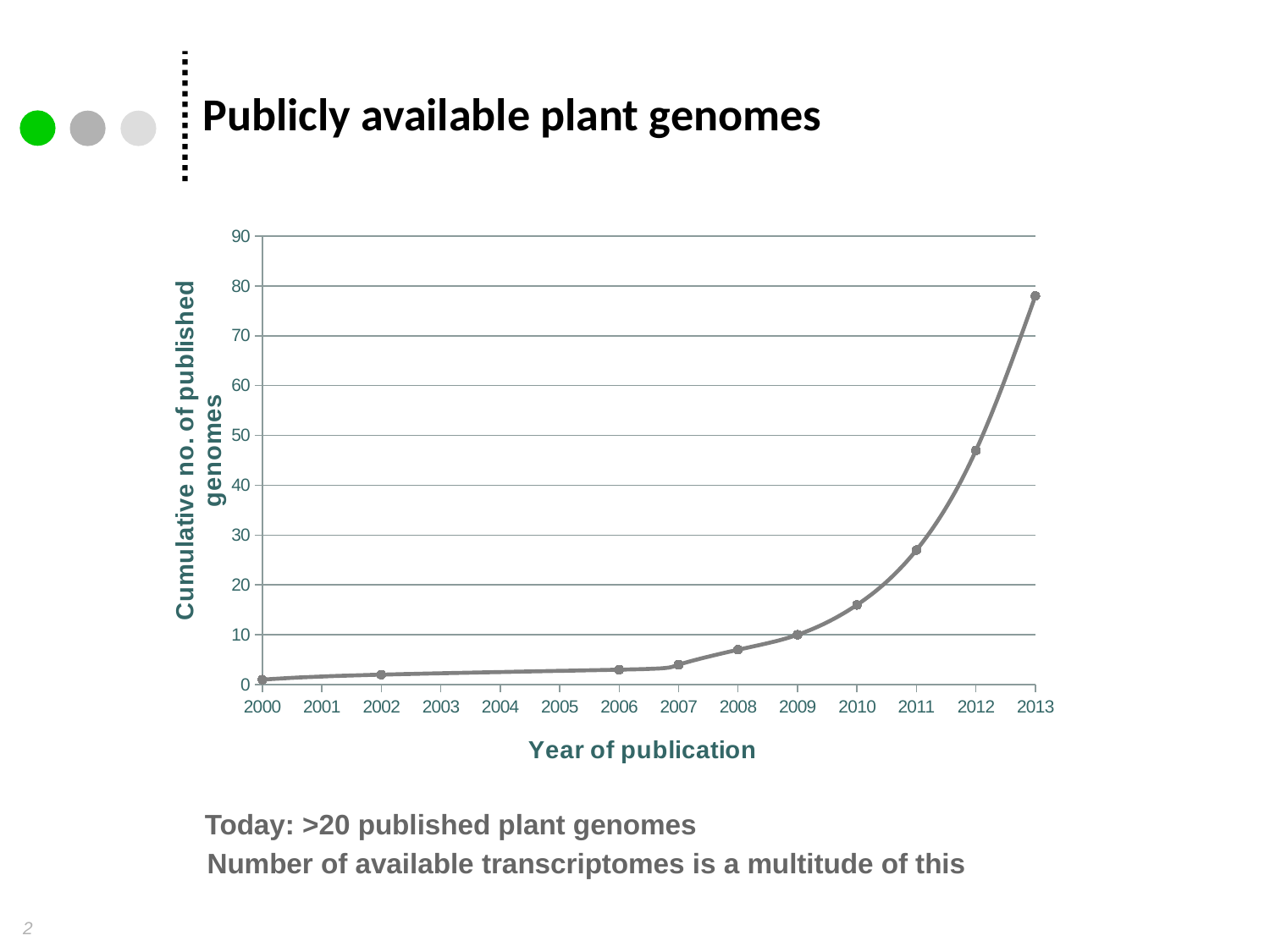
How many data points are plotted on the line? 10 Do the values rise or fall from 2000 to 2013? rise What kind of chart is shown on the slide? line chart Is the value for 2012 greater or less than 50? less Which year has the lowest cumulative number of published genomes? 2000 What is the title of the x axis? Year of publication Which year has a larger value, 2012 or 2011? 2012 Is the value for 2010 greater or less than 10? greater Which year has the highest cumulative number of published genomes? 2013 Is the value for 2008 greater or less than 10? less